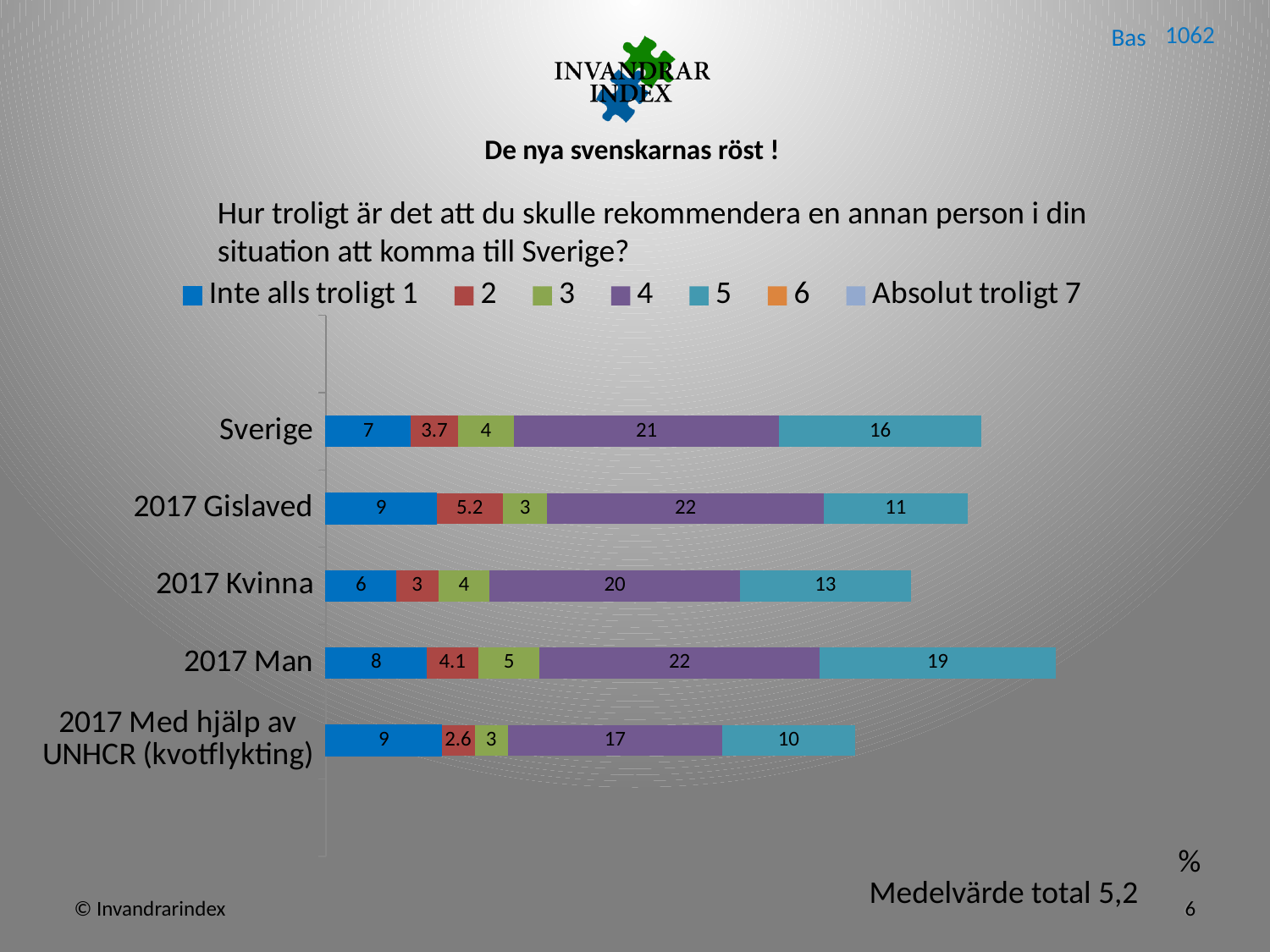
What kind of chart is shown on the slide? Stacked bar chart What is the difference between the "5" segment values for 2017 Man and 2017 Kvinna? 6 What is the value of the "Inte alls troligt 1" segment for 2017 Kvinna? 6 What is the value of the "5" segment for 2017 Med hjälp av UNHCR (kvotflykting)? 10 How many categories are shown on the chart? 5 Which category has the highest value for the "5" segment? 2017 Man Which is larger, the "Inte alls troligt 1" value for Sverige or for 2017 Gislaved? 2017 Gislaved What is the value of the "2" segment for 2017 Gislaved? 5.2 What is the value of the "4" segment for Sverige? 21 What is the first entry in the chart legend? Inte alls troligt 1 Which category has the lowest value for the "4" segment? 2017 Med hjälp av UNHCR (kvotflykting) How many series does the legend list? 7